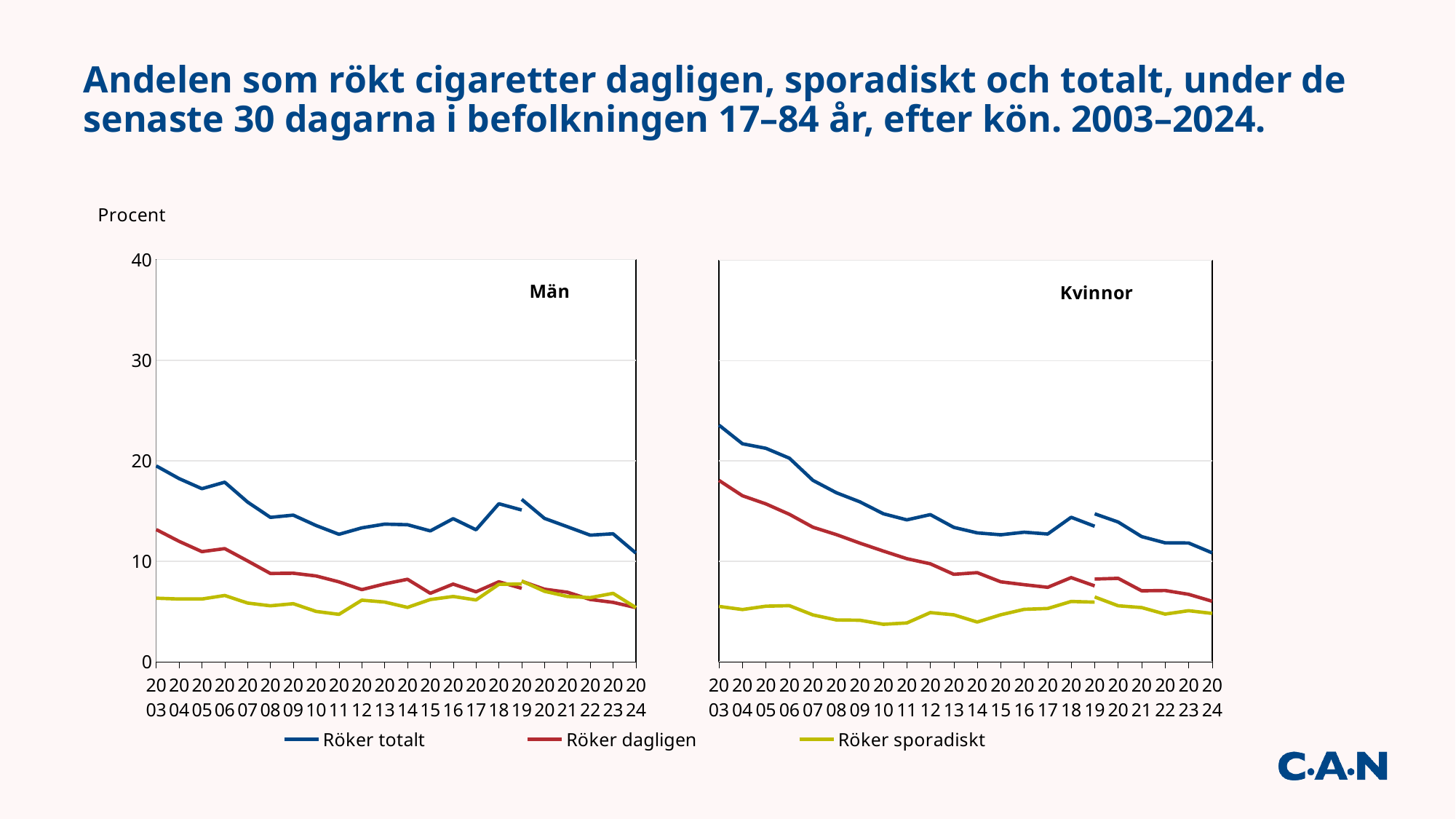
In the Kvinnor chart, is the value for Röker totalt in 2003 greater or less than 20? greater How many years are plotted along the x axis of the Kvinnor chart? 22 In the Kvinnor chart, is the value for Röker dagligen in 2003 greater or less than 10? greater In the Män chart, is the value for Röker sporadiskt in 2011 greater or less than 10? less In the Män chart, does the Röker totalt line rise or fall from 2003 to 2024? Fall In the Kvinnor chart, does the Röker dagligen line rise or fall from 2003 to 2024? Fall How many series does the legend list? 3 In the Kvinnor chart, which year has the highest value for Röker totalt? 2003 What kind of chart is the Män chart? Line chart In the Män chart, which year has the lowest value for Röker totalt? 2024 What colour is the Röker sporadiskt line in the legend? Yellow Which is larger in 2003: Röker totalt in the Män chart or Röker totalt in the Kvinnor chart? Kvinnor